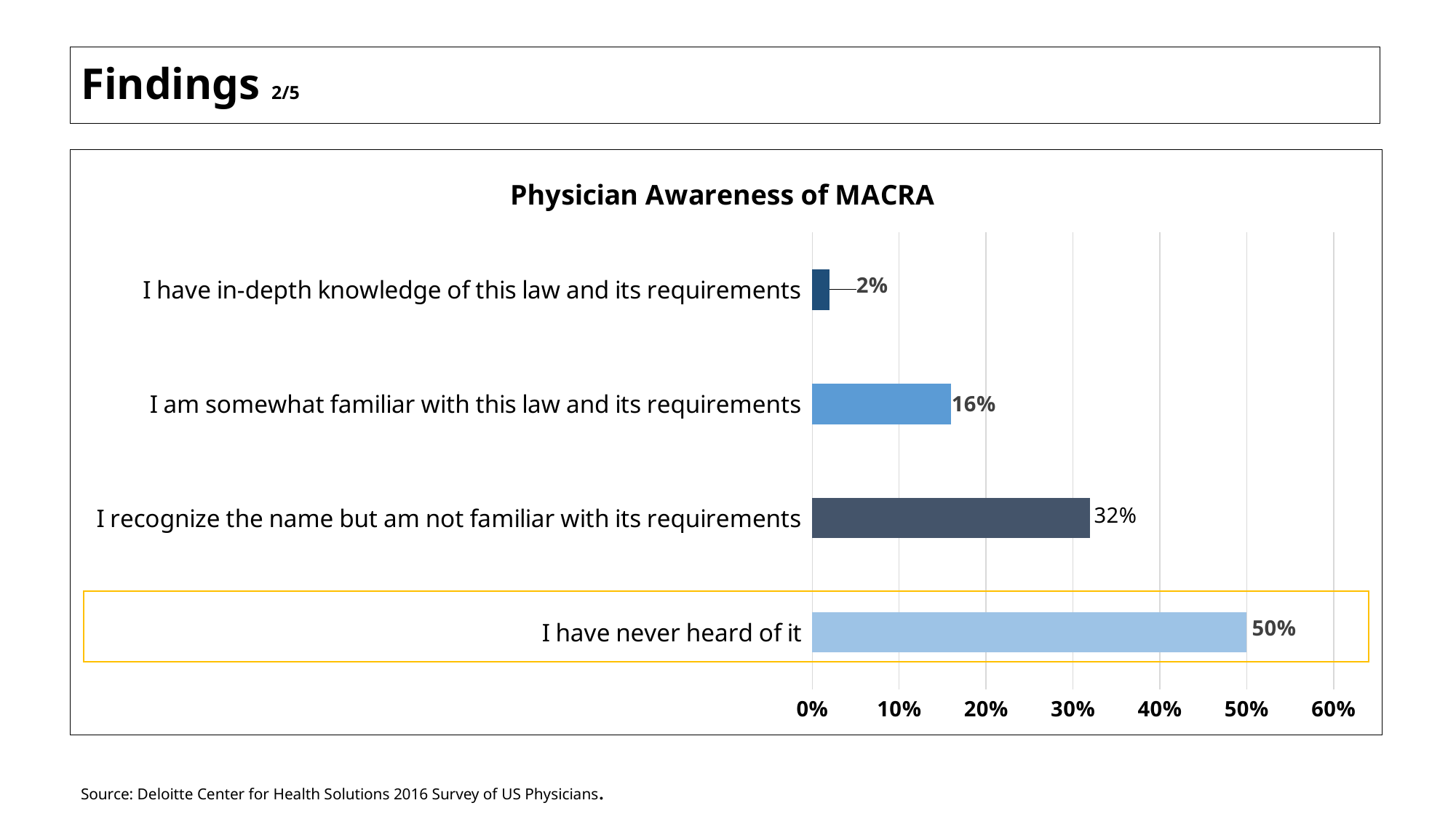
What is the difference between the value for "I am somewhat familiar with this law and its requirements" and the value for "I have in-depth knowledge of this law and its requirements"? 14% Which category has the lowest value? I have in-depth knowledge of this law and its requirements Which is larger: the value for "I am somewhat familiar with this law and its requirements" or the value for "I recognize the name but am not familiar with its requirements"? I recognize the name but am not familiar with its requirements What is the value for "I recognize the name but am not familiar with its requirements"? 32% Which category has the highest value? I have never heard of it What percentage of physicians said they have never heard of MACRA? 50% What kind of chart is shown on the slide? Bar chart What is the value for "I am somewhat familiar with this law and its requirements"? 16% What is the difference between the value for "I have never heard of it" and the value for "I recognize the name but am not familiar with its requirements"? 18% What is the title of the chart? Physician Awareness of MACRA What percentage of physicians said they have in-depth knowledge of this law and its requirements? 2% How many categories are shown in the chart? 4